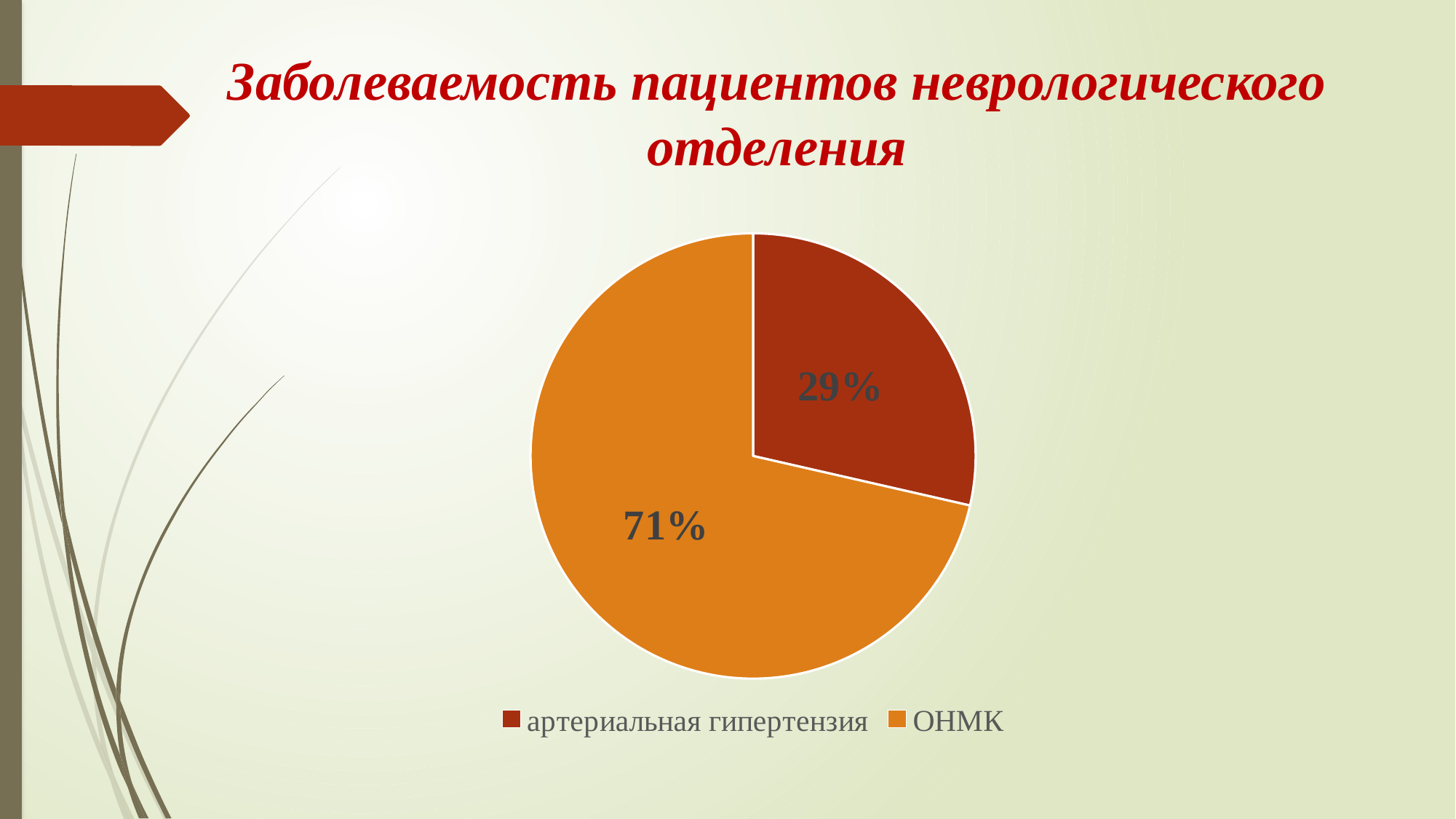
What share of the pie does артериальная гипертензия account for? 29% Which category has the largest slice of the pie? ОНМК How many entries does the legend list? 2 How many slices does the pie chart have? 2 Which is larger, the slice for ОНМК or the slice for артериальная гипертензия? ОНМК What kind of chart is shown on the slide? pie chart Which category has the smallest slice of the pie? артериальная гипертензия Which category is shown in the dark red colour in the pie chart? артериальная гипертензия What is the title of the slide containing the chart? Заболеваемость пациентов неврологического отделения What is the difference in percentage points between the ОНМК slice and the артериальная гипертензия slice? 42 What share of the pie does ОНМК account for? 71%